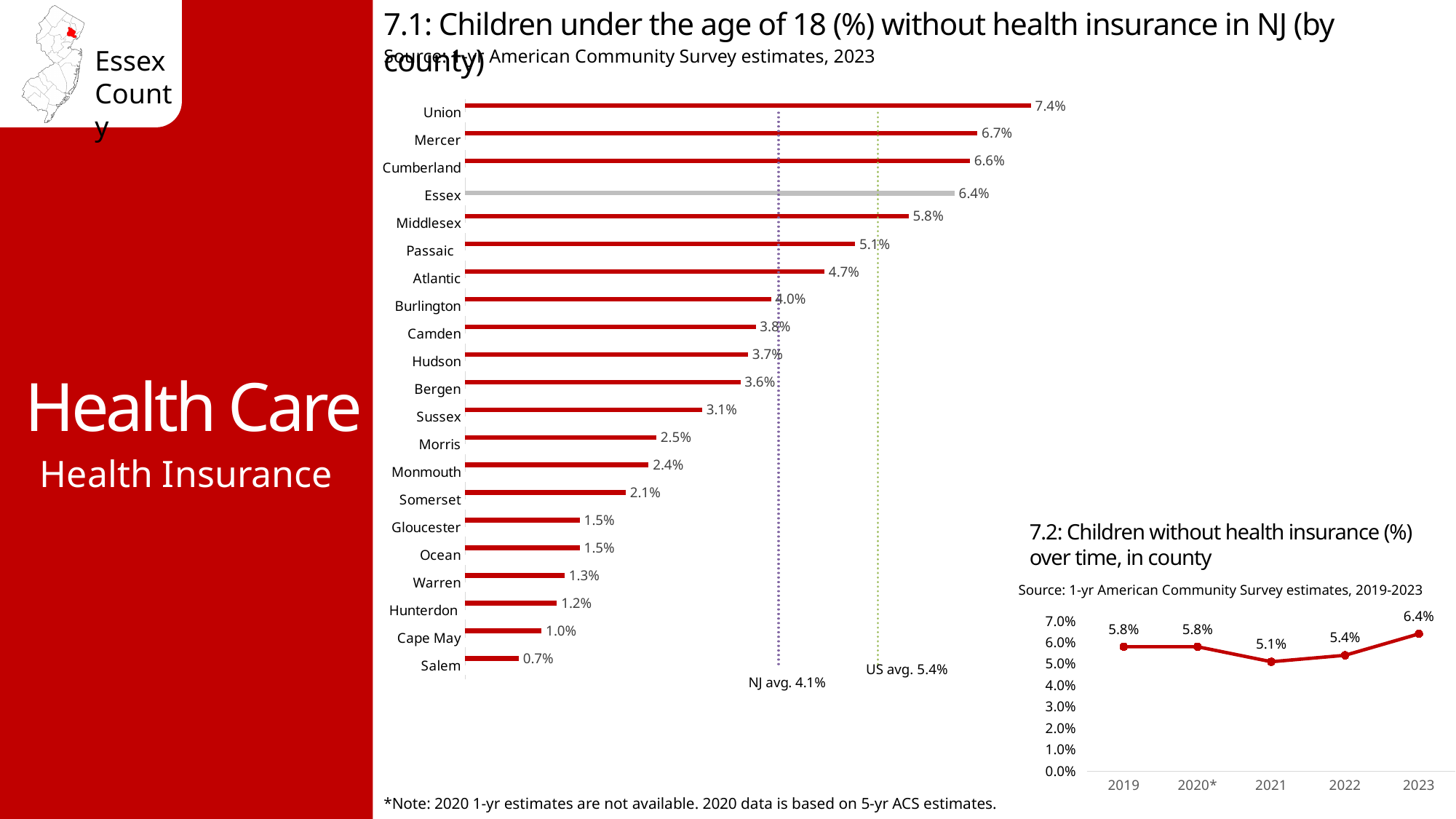
In chart 7.1, which county has a larger value, Passaic or Atlantic? Passaic What kind of chart is chart 7.2? Line chart In chart 7.1, how many counties are plotted? 21 In chart 7.2, which year has the highest value? 2023 In chart 7.1, what is the difference between the values for Union and Salem? 6.7% In chart 7.2, what is the difference between the 2023 and 2022 values? 1.0% In chart 7.1, which county has the lowest percentage of children without health insurance? Salem In chart 7.1, what is the NJ average shown by the dotted reference line? 4.1% In chart 7.1, which county has the highest percentage of children without health insurance? Union In chart 7.1 (children under 18 without health insurance by county), what is the value for Essex? 6.4% In chart 7.2 (children without health insurance over time), what is the value for 2021? 5.1% What kind of chart is chart 7.1? Bar chart